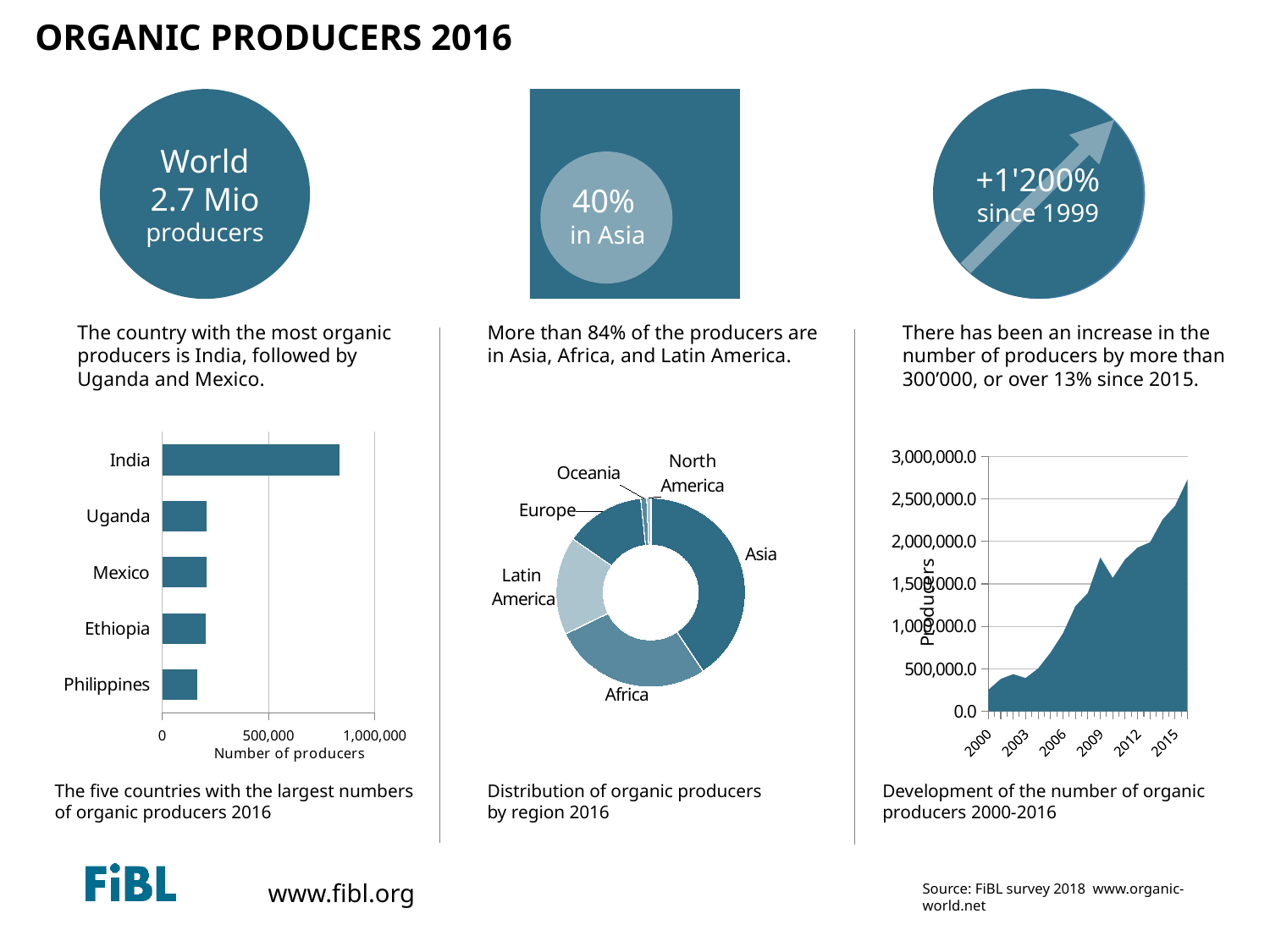
On the chart showing the distribution of organic producers by region 2016, which slice is larger, Africa or Europe? Africa On the bar chart of the five countries with the largest numbers of organic producers, what is the title of the horizontal axis? Number of producers On the chart showing the distribution of organic producers by region 2016, which region has the largest slice? Asia What kind of chart is the chart of the five countries with the largest numbers of organic producers? bar chart On the bar chart of the five countries with the largest numbers of organic producers, which country has the lowest value? Philippines On the chart showing the development of the number of organic producers 2000-2016, do the values generally rise or fall from 2000 to 2016? rise On the bar chart of the five countries with the largest numbers of organic producers, is the value for India greater or less than 500,000? greater On the chart showing the distribution of organic producers by region 2016, how many regions are shown? 6 On the bar chart of the five countries with the largest numbers of organic producers, which country has the highest value? India On the chart showing the development of the number of organic producers 2000-2016, is the value for 2016 greater or less than 2,500,000? greater On the bar chart of the five countries with the largest numbers of organic producers, is the value for Uganda greater or less than 500,000? less On the bar chart of the five countries with the largest numbers of organic producers, how many countries are shown? 5